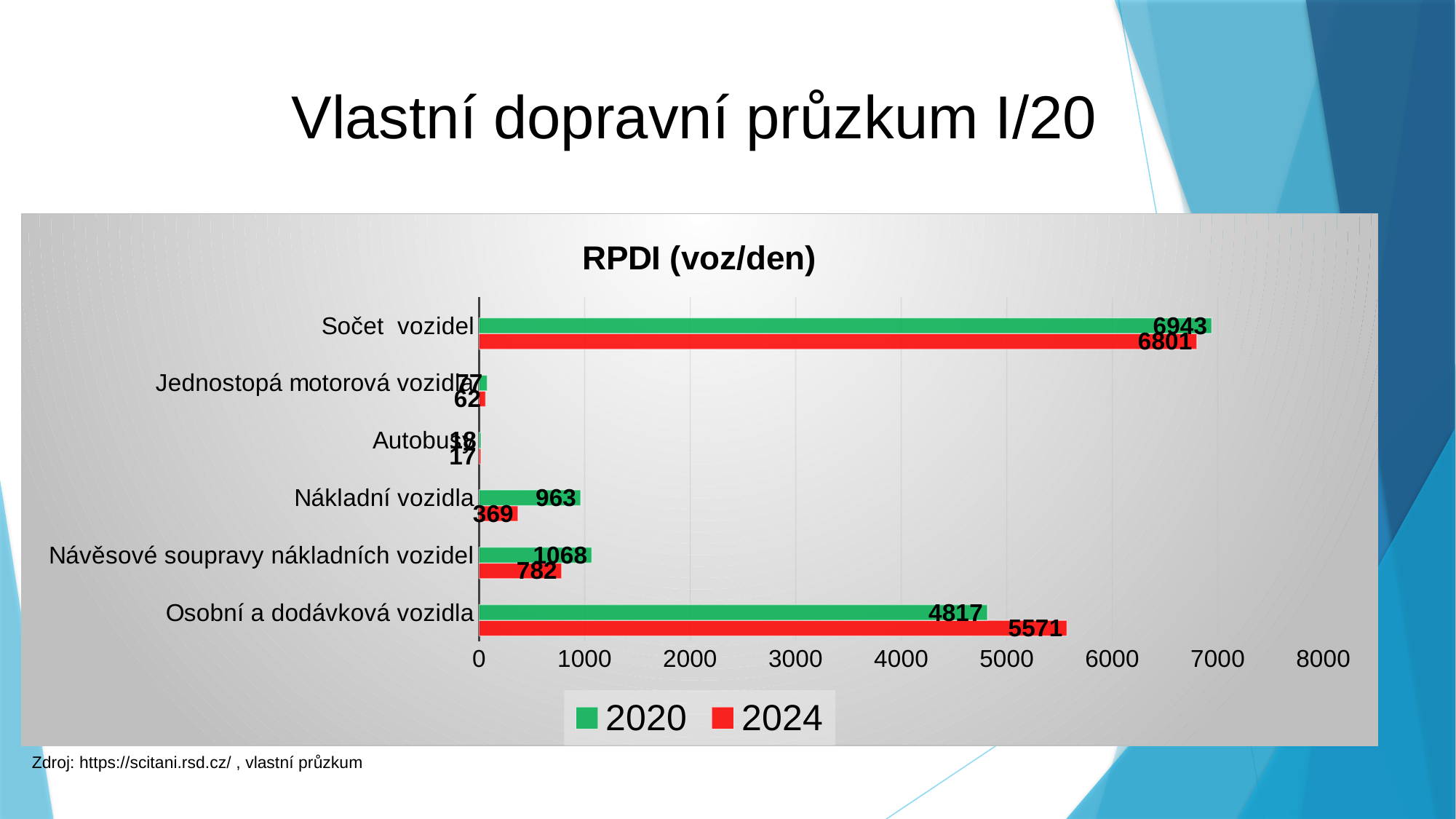
What is the difference between the 2020 and 2024 values for Nákladní vozidla? 594 For Osobní a dodávková vozidla, which series has the larger value, 2020 or 2024? 2024 What is the 2024 value for Osobní a dodávková vozidla? 5571 What is the 2024 value for Nákladní vozidla? 369 What is the difference between the 2020 and 2024 values for Sočet vozidel? 142 What is the 2024 value for Jednostopá motorová vozidla? 62 Which category has the highest 2024 value? Sočet vozidel What kind of chart is shown on the slide? bar chart What is the title of the chart? RPDI (voz/den) What is the 2020 value for Sočet vozidel? 6943 What is the 2020 value for Návěsové soupravy nákladních vozidel? 1068 How many series does the legend list? 2